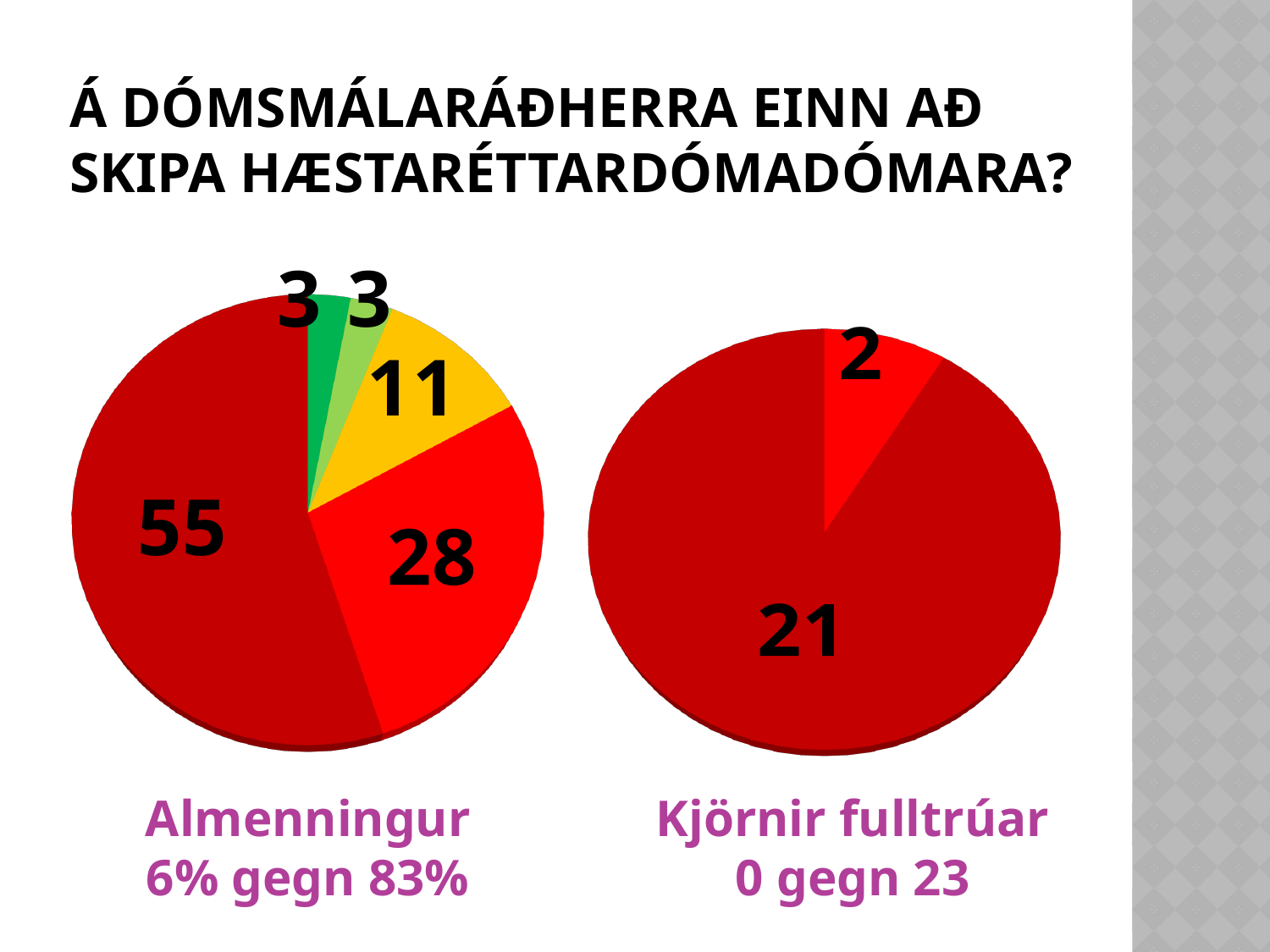
In the "Almenningur" pie chart, what is the value of the yellow slice? 11 In the "Kjörnir fulltrúar" pie chart, what is the value of the largest slice? 21 What text is shown beneath the right-hand pie chart? Kjörnir fulltrúar 0 gegn 23 In the "Almenningur" pie chart, what is the value of the bright red slice? 28 What kind of chart is shown under the label "Almenningur"? pie chart In the "Almenningur" pie chart, what is the value of the largest slice? 55 In the "Almenningur" pie chart, what is the difference between the dark red slice (55) and the bright red slice (28)? 27 In the "Kjörnir fulltrúar" pie chart, what is the value of the small bright red slice? 2 How many slices does the "Almenningur" pie chart have? 5 How many slices does the "Kjörnir fulltrúar" pie chart have? 2 Which is larger: the dark red slice in the "Almenningur" pie chart or the dark red slice in the "Kjörnir fulltrúar" pie chart? Almenningur (55) In the "Almenningur" pie chart, what is the total of all the slice values? 100